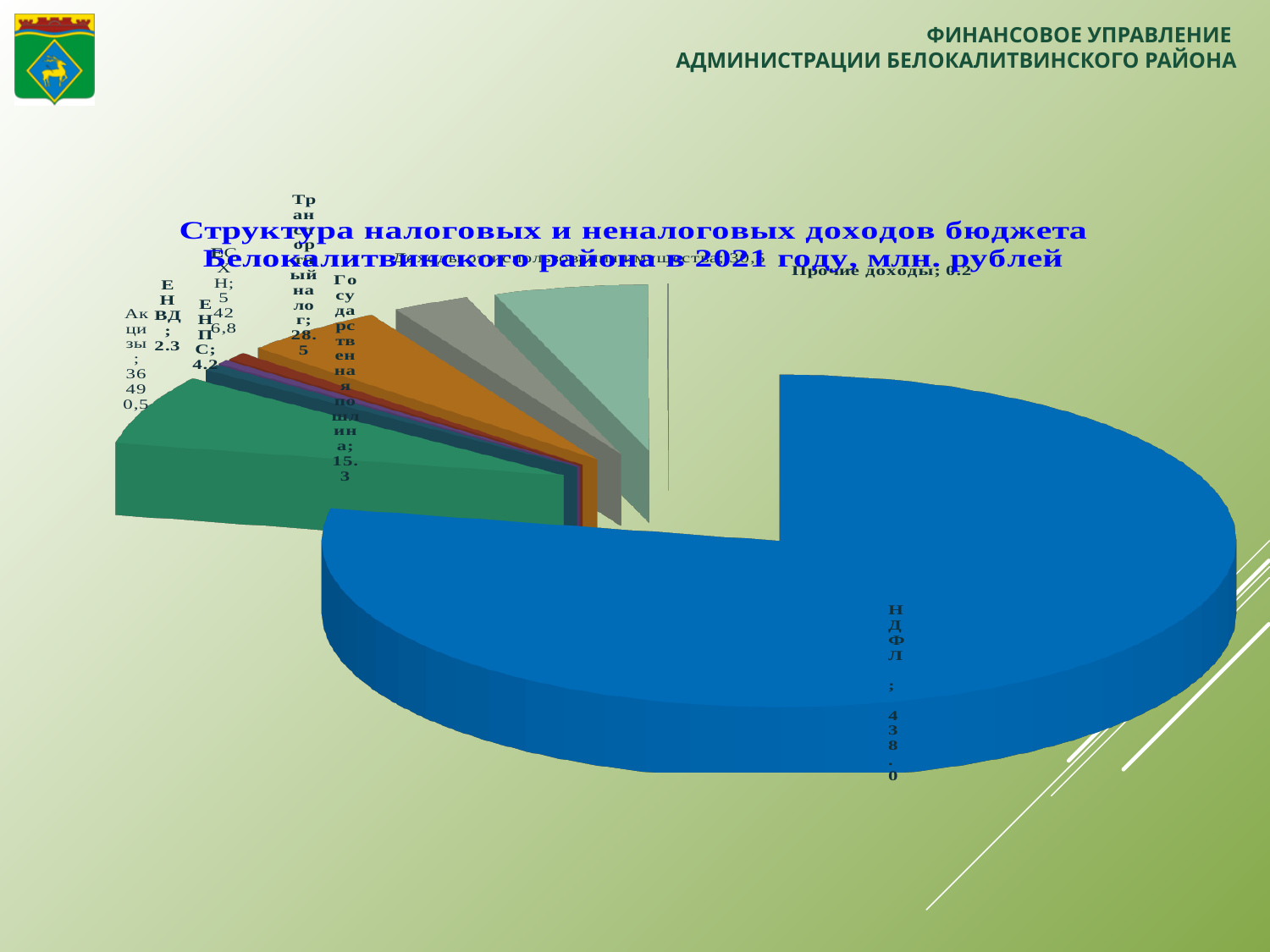
What is the difference between the values for НДФЛ and Государственная пошлина? 422.7 What is the value for Прочие доходы in the pie chart? 0.2 What is the value for НДФЛ in the pie chart? 438.0 What is the value for ЕНВД in the pie chart? 2.3 In what units are the values in the chart expressed, according to the chart title? млн. рублей What is the difference between the values for Транспортный налог and Государственная пошлина? 13.2 What kind of chart is shown on the slide? pie chart Which is larger, the value for Транспортный налог or the value for Государственная пошлина? Транспортный налог What is the value for Государственная пошлина in the pie chart? 15.3 What is the value for Транспортный налог in the pie chart? 28.5 Which is larger, the value for НДФЛ or the value for Транспортный налог? НДФЛ Which category has the largest slice in the pie chart? НДФЛ